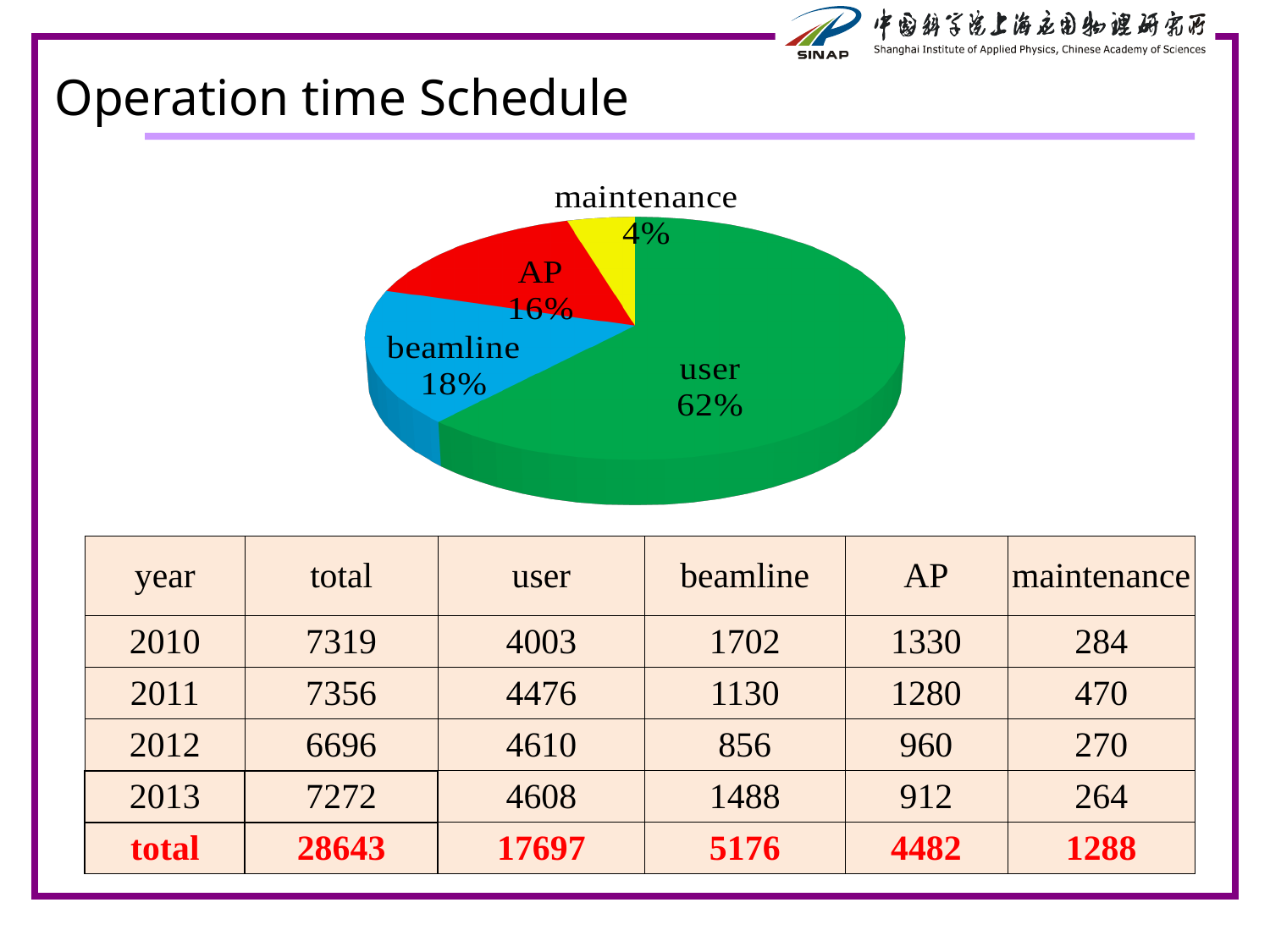
What colour is the user slice in the pie chart? green How many slices does the pie chart have? 4 What share of the pie does the AP slice represent? 16% What share of the pie does the user slice represent? 62% Which slice of the pie chart is the smallest? maintenance What share of the pie does the beamline slice represent? 18% What is the difference in percentage points between the user slice and the beamline slice? 44 Which slice of the pie chart is the largest? user What share of the pie does the maintenance slice represent? 4% Which is larger in the pie chart, the beamline slice or the AP slice? beamline What kind of chart is shown on the slide? pie chart What is the difference in percentage points between the AP slice and the maintenance slice? 12